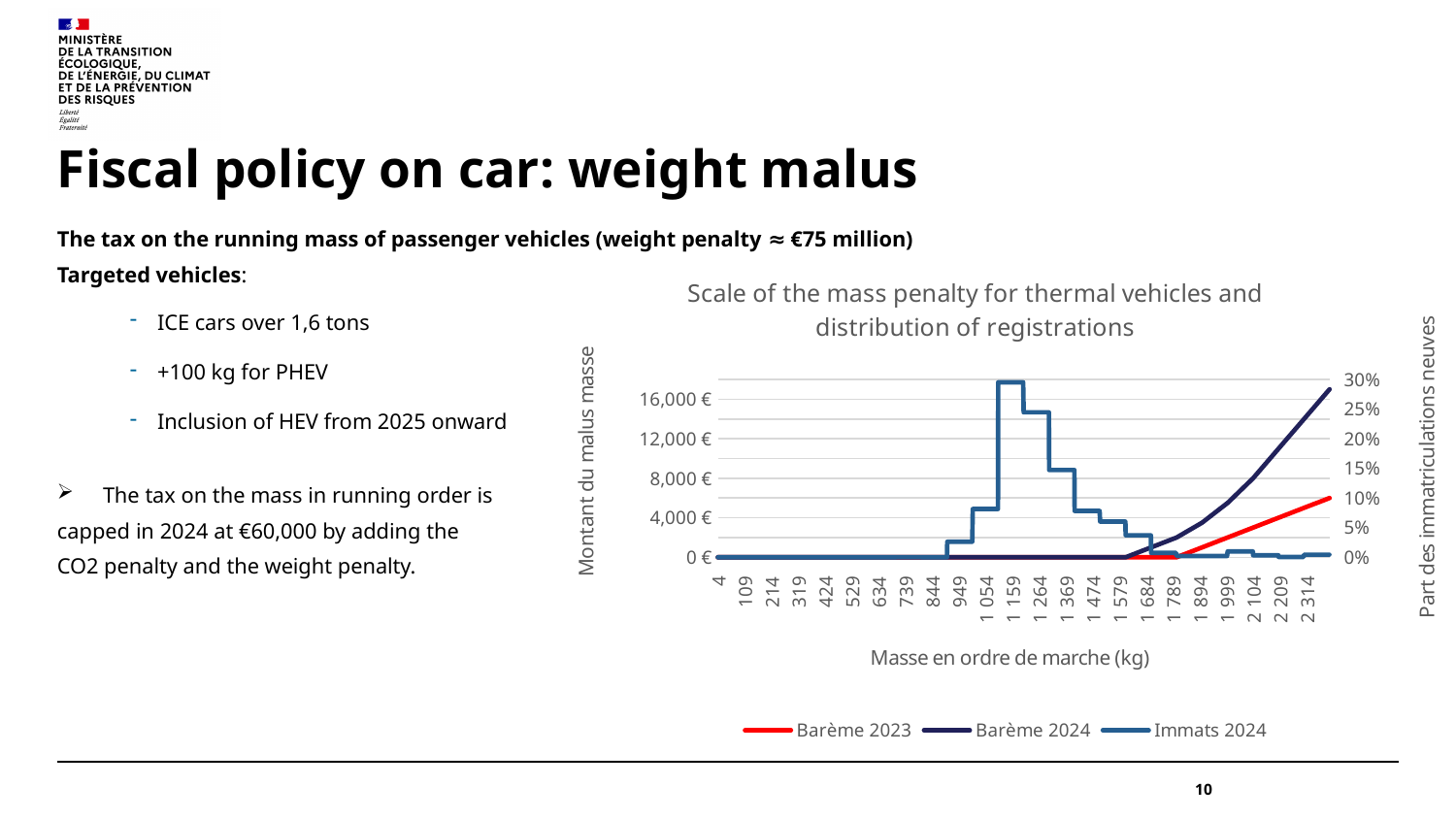
Is the Barème 2024 value at 2 314 kg greater or less than 12,000 €? greater Is the peak share of Immats 2024 greater or less than 25%? greater At 2 314 kg, which series is higher: Barème 2024 or Barème 2023? Barème 2024 What kind of chart is shown on the slide? Line chart Which series is drawn in red in the chart? Barème 2023 Does the Barème 2024 series rise or fall as mass increases beyond 1 579 kg? Rise How many series does the chart legend list? 3 What is the label of the chart's x axis? Masse en ordre de marche (kg) How many tick labels are shown on the x axis of the chart? 23 Is the Barème 2023 value at 2 314 kg greater or less than 8,000 €? less What is the title of the chart? Scale of the mass penalty for thermal vehicles and distribution of registrations